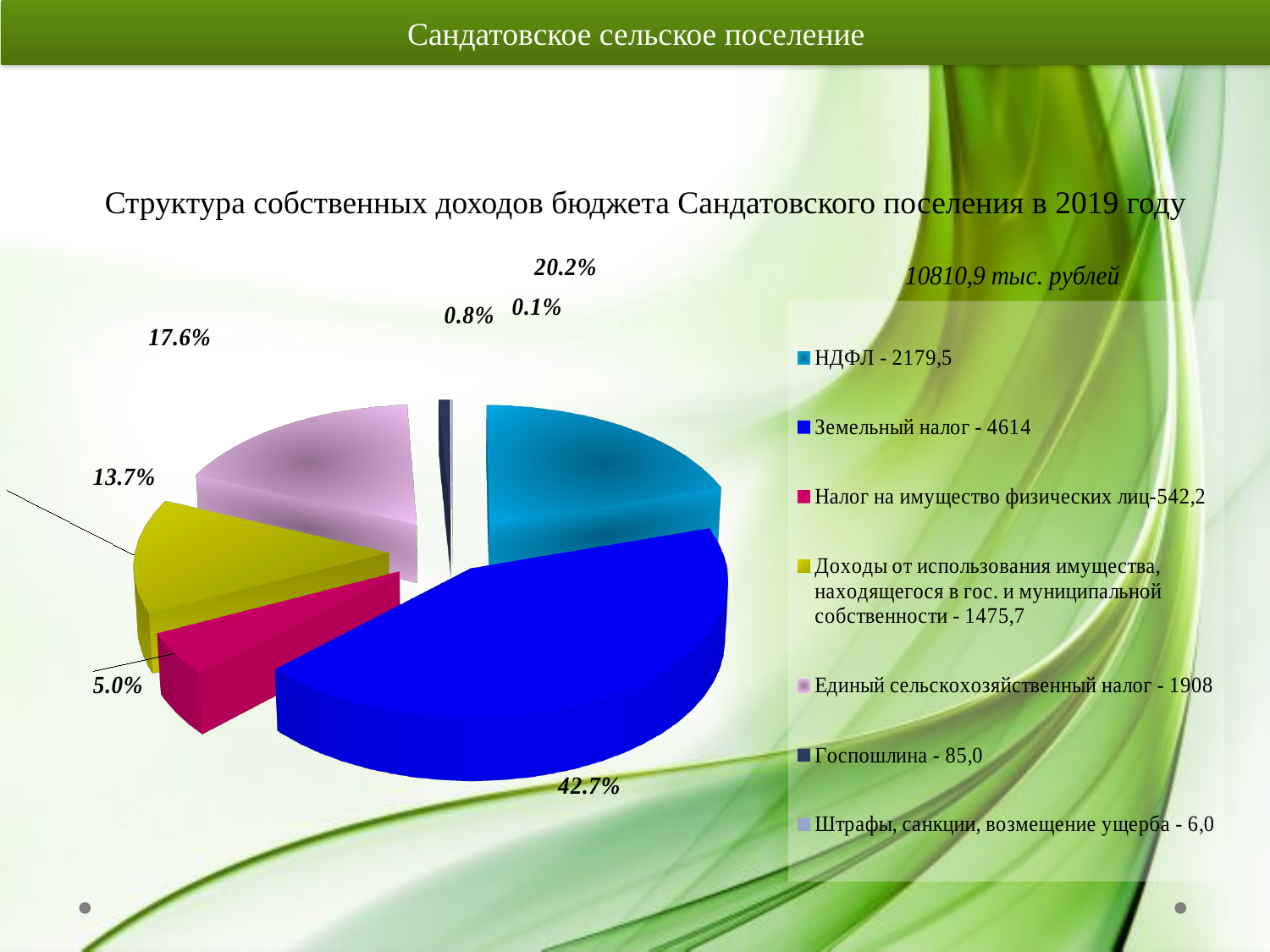
What share of the pie does НДФЛ take? 20.2% What value is given in the legend for Налог на имущество физических лиц? 542,2 What share of the pie does Земельный налог take? 42.7% What kind of chart is shown on the slide? pie chart Which is larger: the value for Единый сельскохозяйственный налог or the value for Доходы от использования имущества, находящегося в гос. и муниципальной собственности? Единый сельскохозяйственный налог Which category has the largest share of the pie? Земельный налог Which category has the smallest share of the pie? Штрафы, санкции, возмещение ущерба What total amount is shown above the legend of the chart? 10810,9 тыс. рублей What share of the pie does Единый сельскохозяйственный налог take? 17.6% How many categories does the legend of the pie chart list? 7 What value is given in the legend for Госпошлина? 85,0 What is the difference between the legend values for Земельный налог and НДФЛ? 2434,5